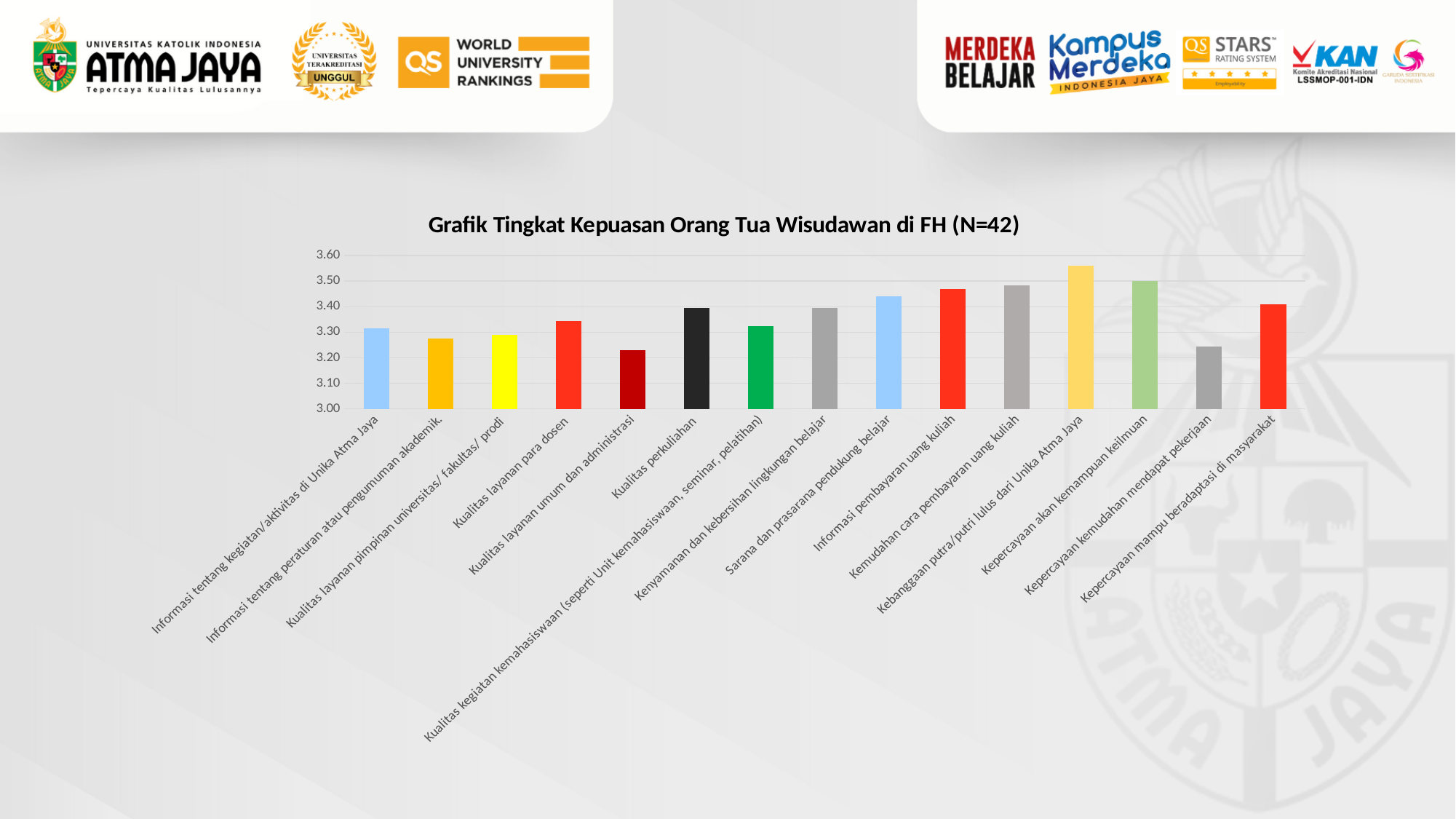
Is the value for Kepercayaan kemudahan mendapat pekerjaan greater or less than 3.30? less Is the value for Kualitas layanan para dosen greater or less than 3.30? greater Is the value for Sarana dan prasarana pendukung belajar greater or less than 3.40? greater Which is larger: the value for Kebanggaan putra/putri lulus dari Unika Atma Jaya or the value for Kualitas layanan umum dan administrasi? Kebanggaan putra/putri lulus dari Unika Atma Jaya Which category has the highest value in the chart? Kebanggaan putra/putri lulus dari Unika Atma Jaya How many categories are plotted in the chart? 15 What type of chart is shown on the slide? Bar chart What is the title of the chart? Grafik Tingkat Kepuasan Orang Tua Wisudawan di FH (N=42) What sample size (N) is stated in the chart title? 42 Which is larger: the value for Sarana dan prasarana pendukung belajar or the value for Informasi tentang peraturan atau pengumuman akademik? Sarana dan prasarana pendukung belajar